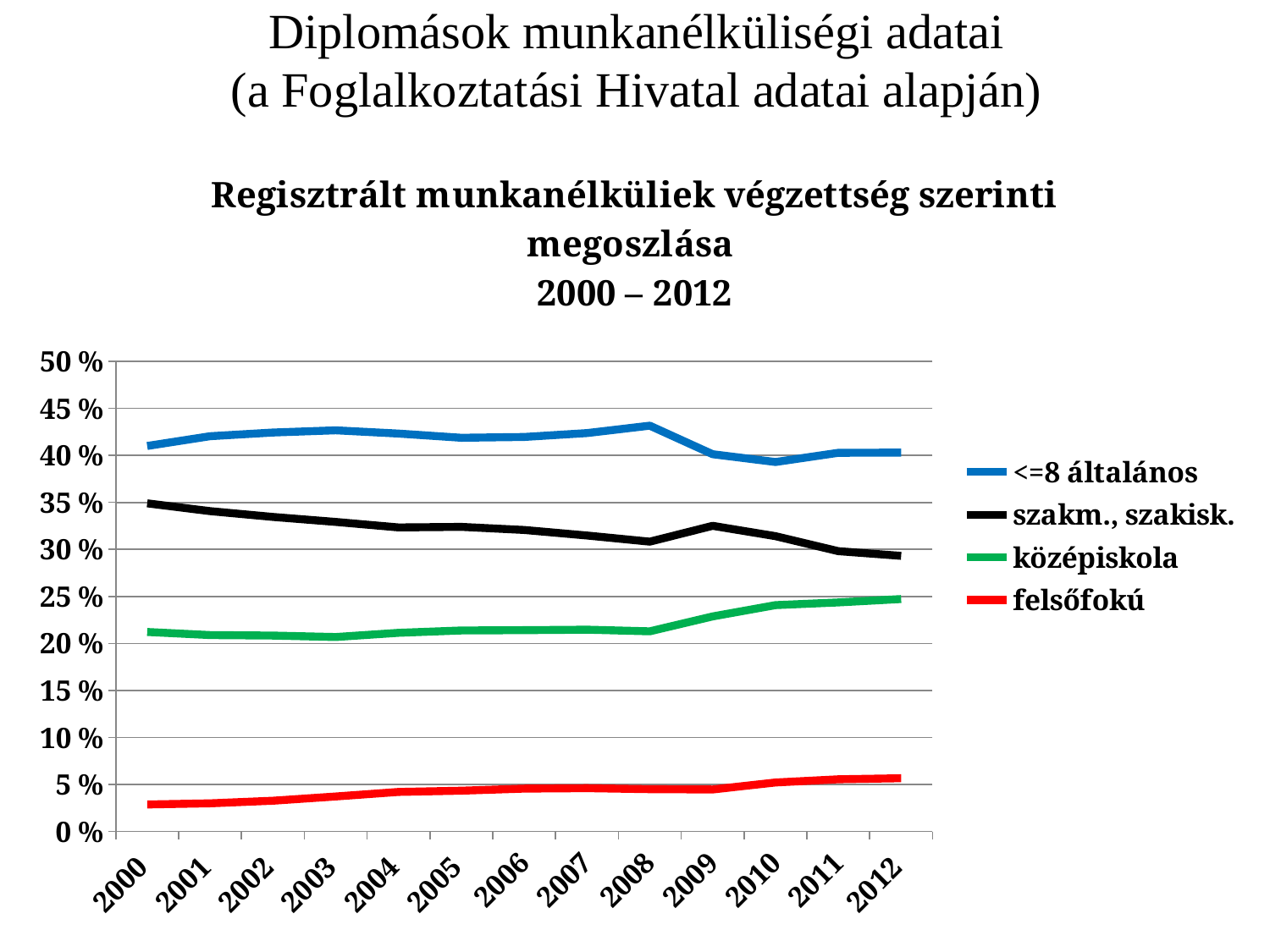
How many series does the legend list? 4 Is the value for középiskola in 2003 greater or less than 25 %? less Which is larger in 2012, középiskola or felsőfokú? középiskola Which series has the lowest values across the whole period? felsőfokú What colour is the line for felsőfokú? red Does the szakm., szakisk. series rise or fall from 2000 to 2012? fall Is the value for <=8 általános in 2008 greater or less than 40 %? greater Is the value for felsőfokú in 2000 greater or less than 5 %? less How many years are plotted along the x axis? 13 What kind of chart is shown on the slide? line chart Which series has the highest values across the whole period? <=8 általános